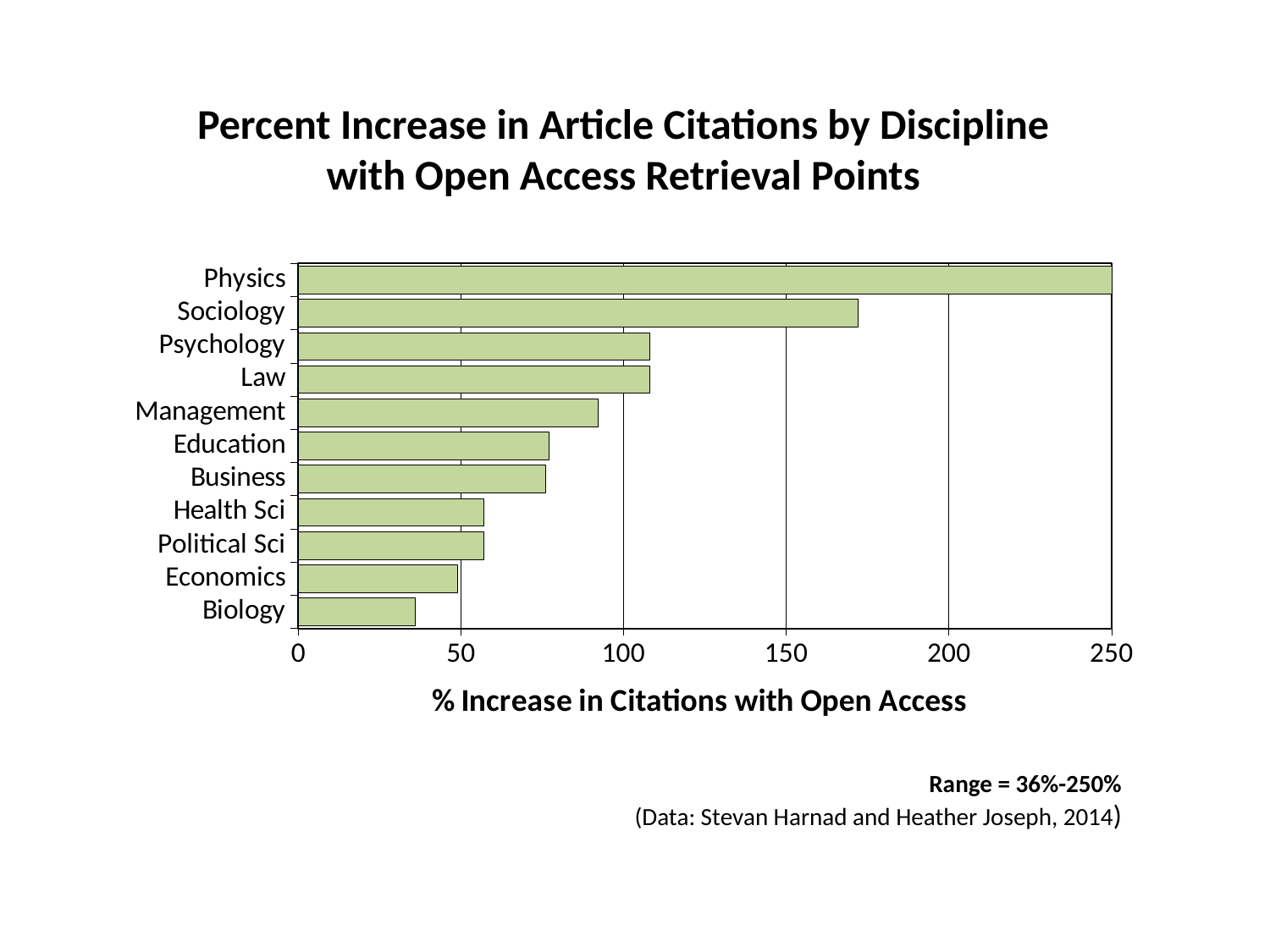
Is the value for Sociology greater or less than 150? greater What is the percent increase in citations for Physics? 250 How many disciplines are plotted in the chart? 11 Which has a larger percent increase in citations, Management or Business? Management Is the value for Management greater or less than 100? less What is the title of the horizontal axis? % Increase in Citations with Open Access What kind of chart is shown on the slide? bar chart According to the range noted on the slide, what is the percent increase for Biology? 36% Which discipline has the lowest percent increase in citations? Biology Is the value for Education greater or less than 50? greater Which discipline has the highest percent increase in citations? Physics Which has a larger percent increase in citations, Sociology or Psychology? Sociology